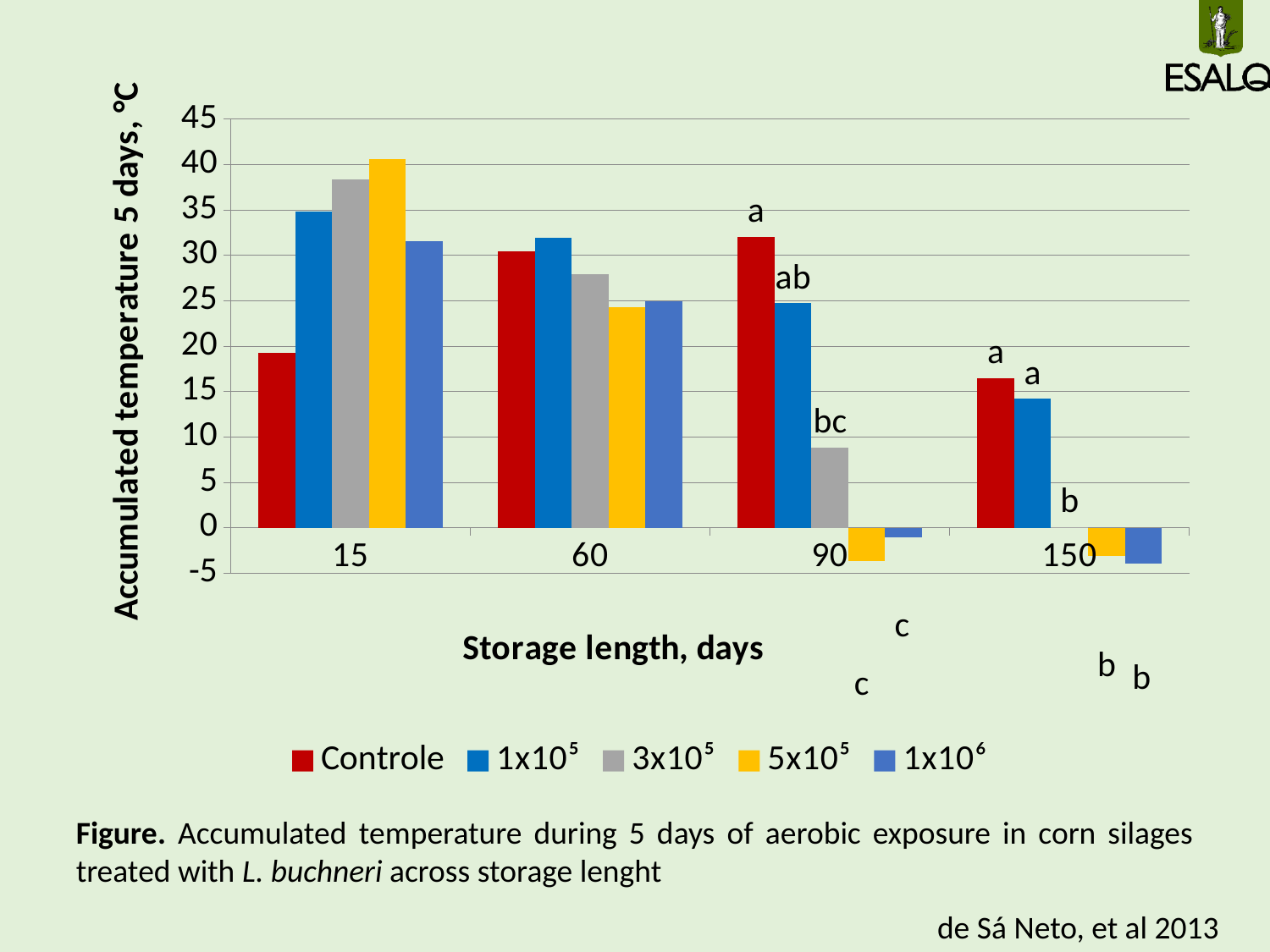
How many storage length categories are shown on the x axis? 4 Is the Controle value at 15 days greater or less than 25? less At 15 days of storage, which series has the highest accumulated temperature? 5x10⁵ What is the title of the x axis? Storage length, days At 15 days of storage, which series has the lowest accumulated temperature? Controle Is the 3x10⁵ value at 90 days greater or less than 15? less Does the 3x10⁵ series rise or fall as storage length increases from 15 to 150 days? fall At 90 days, which is larger: the Controle value or the 1x10⁵ value? Controle How many series does the legend list? 5 At 90 days of storage, which series has the highest accumulated temperature? Controle Is the 5x10⁵ value at 15 days greater or less than 35? greater What kind of chart is shown on the slide? bar chart